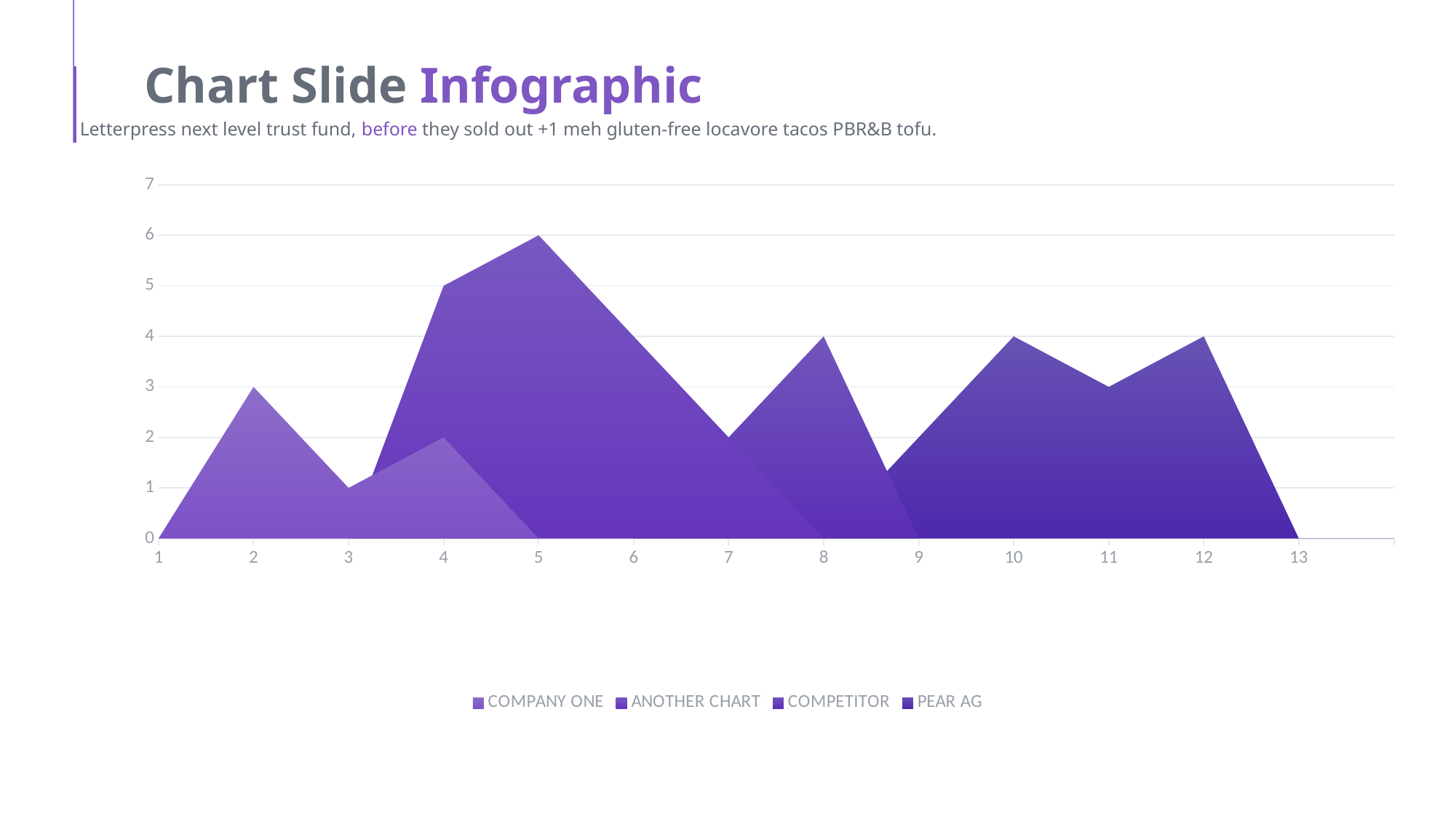
How many series does the legend list? 4 What is the highest value reached by the ANOTHER CHART series? 6 Is the value of the ANOTHER CHART series at point 4 greater or less than 3? greater Which is larger: the PEAR AG value at point 10 or the PEAR AG value at point 11? Point 10 Which series is listed first in the legend? COMPANY ONE What kind of chart is shown on the slide? Area chart What is the value of the COMPETITOR series at point 8? 4 What is the value of the COMPANY ONE series at point 2? 3 At which x-axis point does the ANOTHER CHART series reach its peak? 5 What is the difference between the ANOTHER CHART value at point 5 and the COMPANY ONE value at point 2? 3 What is the value of the PEAR AG series at point 11? 3 How many points are labelled along the x axis? 13